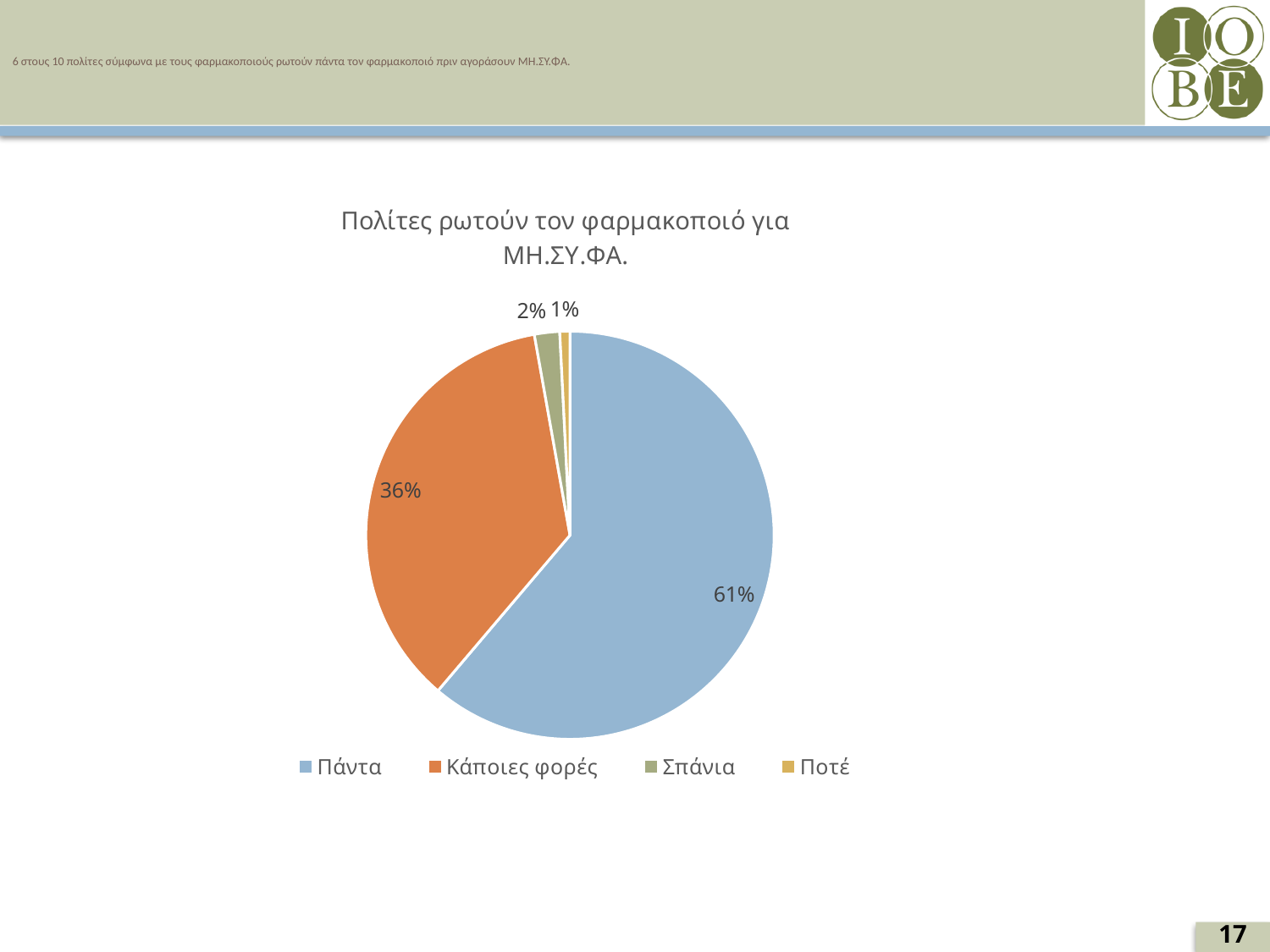
Which category has the smallest slice of the pie? Ποτέ What kind of chart is shown on the slide? pie chart What colour is the 'Κάποιες φορές' slice? orange What is the value for 'Σπάνια'? 2% Which is larger, the 'Κάποιες φορές' slice or the 'Σπάνια' slice? Κάποιες φορές What share of the pie does the 'Πάντα' slice represent? 61% What is the value for 'Ποτέ'? 1% What is the difference between the 'Πάντα' and 'Κάποιες φορές' slices? 25% Which category has the largest slice of the pie? Πάντα What is the title of the chart? Πολίτες ρωτούν τον φαρμακοποιό για ΜΗ.ΣΥ.ΦΑ. What is the value for 'Κάποιες φορές'? 36% How many categories does the legend list? 4